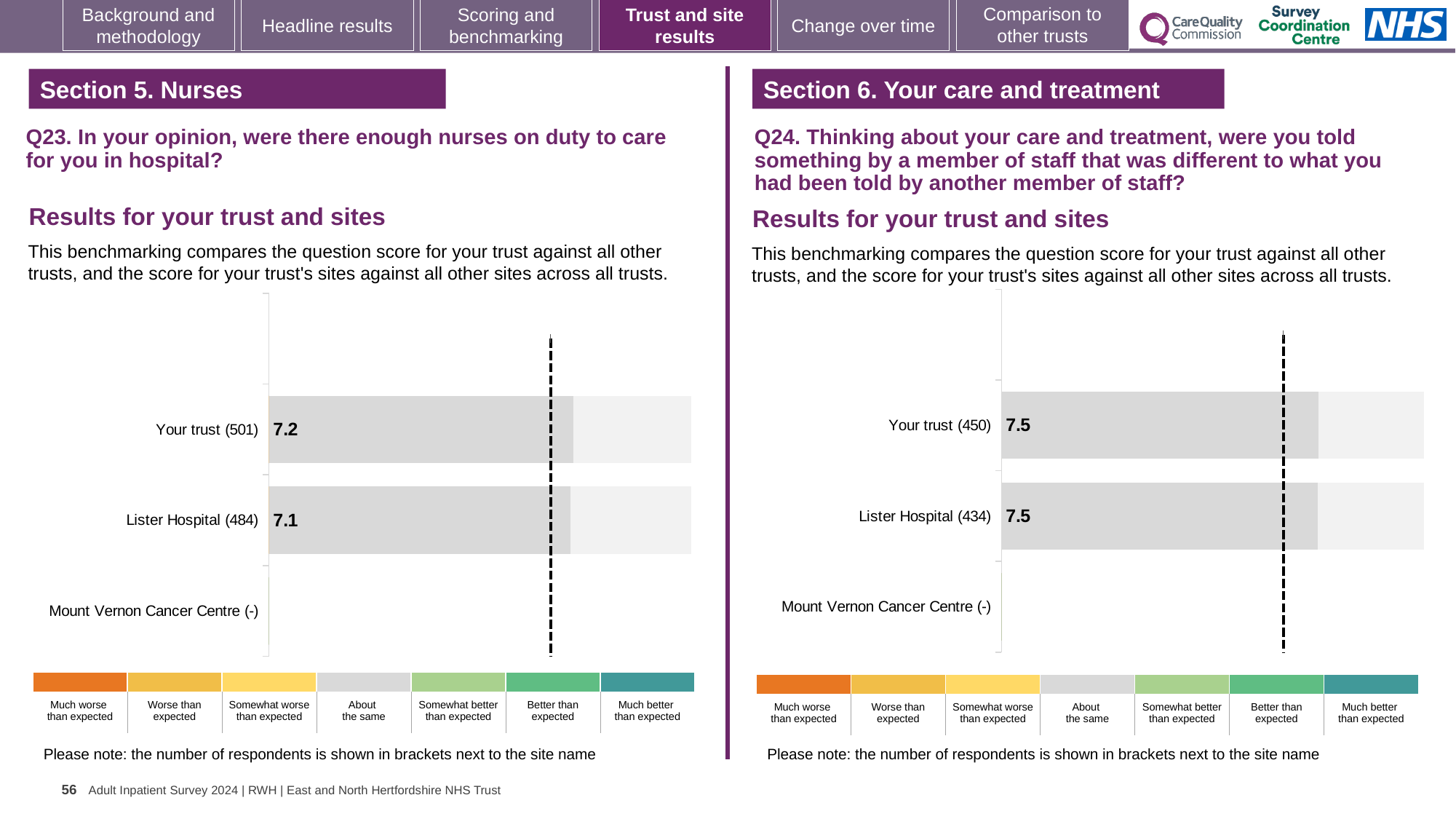
How many rating bands are shown in the colour key below the Q24 chart on the right? 7 In the Q23 chart on the left, which category has no score shown? Mount Vernon Cancer Centre In the Q23 chart on the left, what is the difference between the scores for Your trust and Lister Hospital? 0.1 What kind of chart is used on the left for Q23? Bar chart In the Q23 chart on the left, how many respondents are shown for Your trust? 501 In the Q24 chart on the right, what is the score for Your trust? 7.5 In the Q23 chart on the left, what is the score for Your trust? 7.2 In the Q23 chart on the left, what is the score for Lister Hospital? 7.1 In the Q24 chart on the right, what is the score for Lister Hospital? 7.5 In the Q23 chart on the left, which has the higher score, Your trust or Lister Hospital? Your trust In the Q24 chart on the right, how many respondents are shown for Lister Hospital? 434 How many site/trust categories are listed on the y axis of the Q24 chart on the right? 3